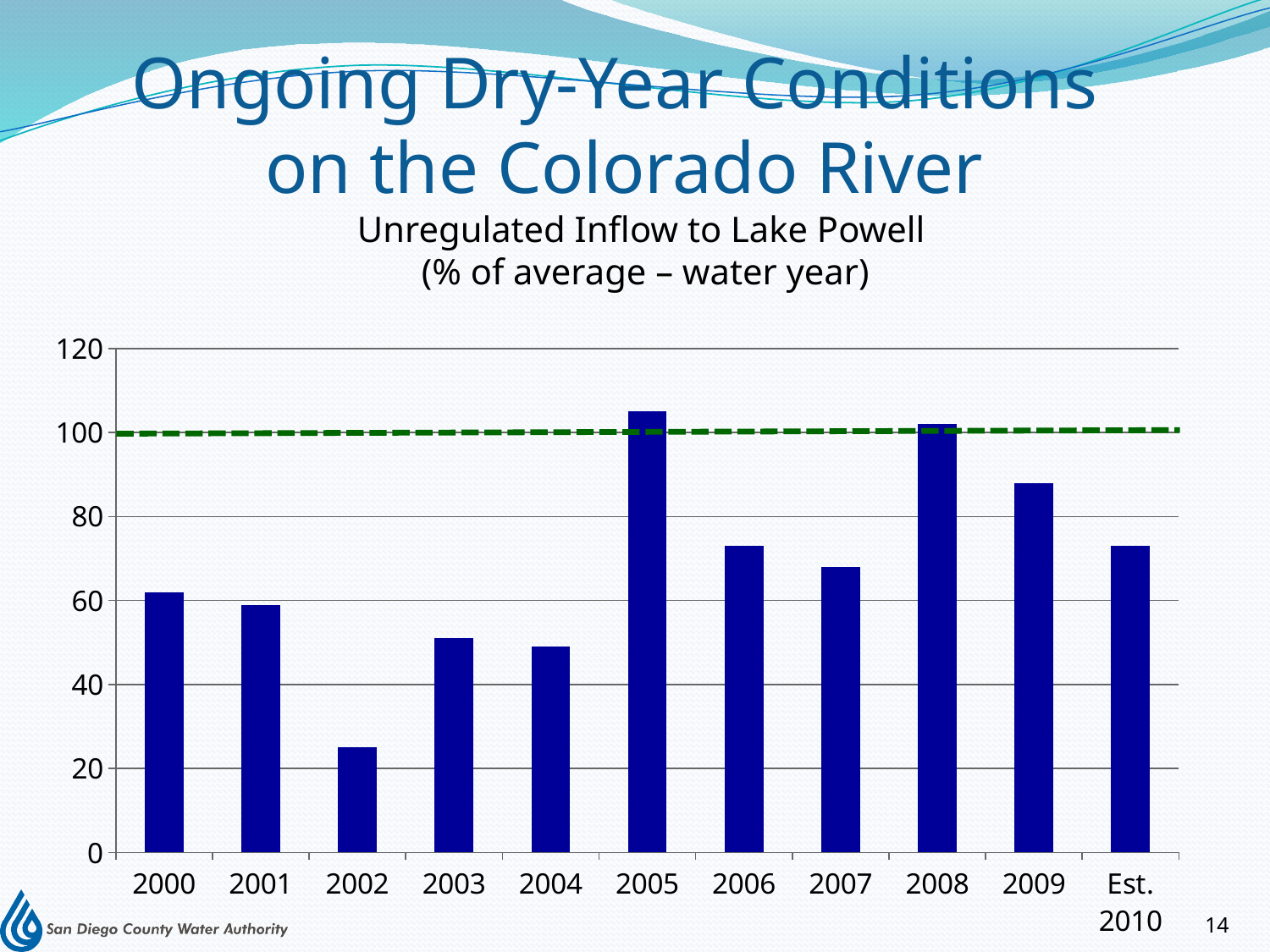
Which year has the highest unregulated inflow to Lake Powell? 2005 Which is larger, the value for 2009 or the value for 2007? 2009 How many years (categories) are plotted on the x axis? 11 Is the value for 2009 greater or less than 80? greater Is the value for 2004 greater or less than 60? less Do the values rise or fall from 2000 to 2002? fall What kind of chart is shown on the slide? bar chart Is the value for 2007 greater or less than 80? less Which year has the lowest unregulated inflow to Lake Powell? 2002 At what level on the y axis is the green dashed horizontal line drawn? 100